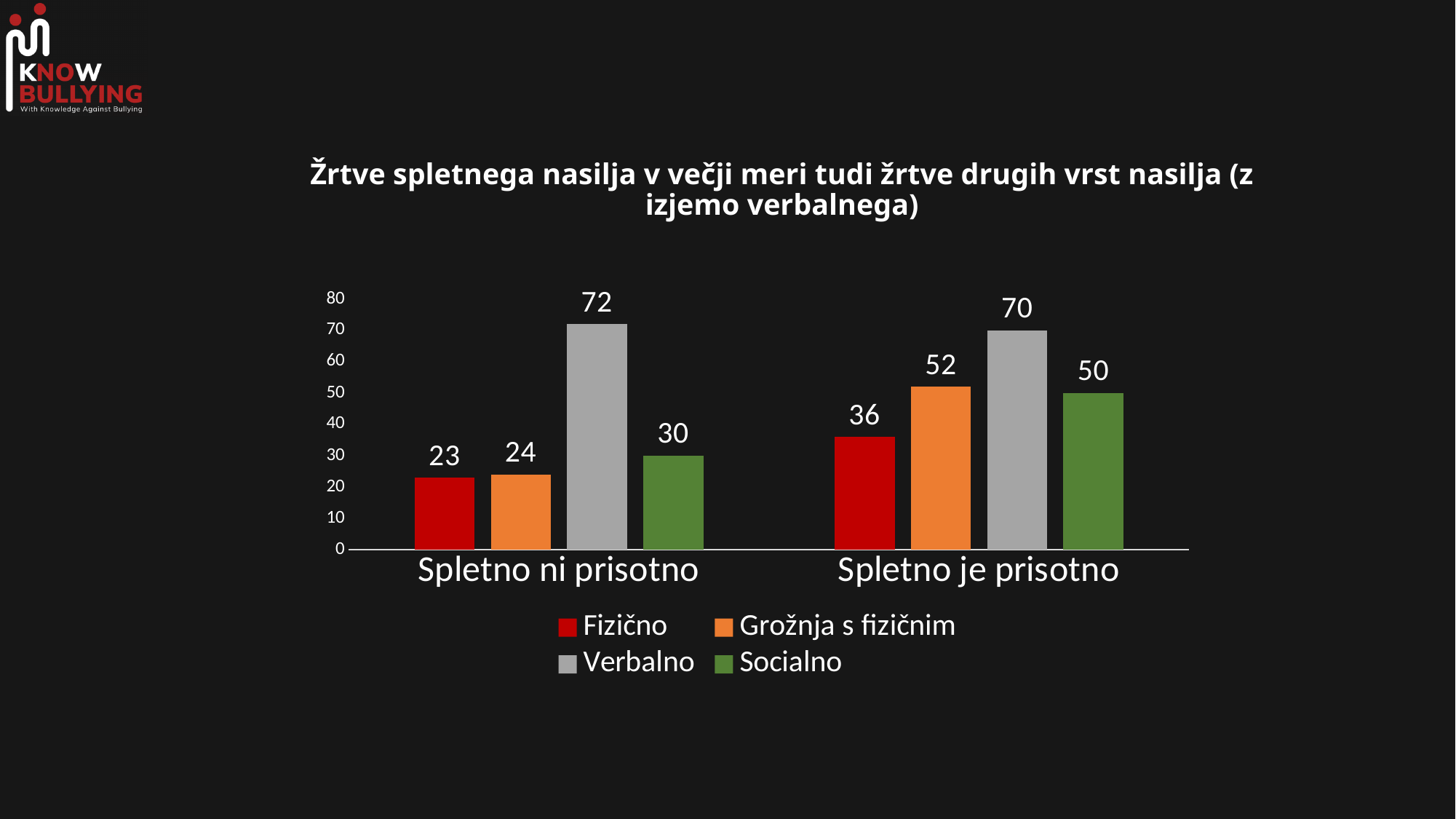
Which is larger: Socialno for Spletno ni prisotno or Socialno for Spletno je prisotno? Spletno je prisotno What kind of chart is shown on the slide? Bar chart How many series does the legend list? 4 Which colour represents the Verbalno series? Grey What is the difference between the Grožnja s fizičnim values for Spletno je prisotno and Spletno ni prisotno? 28 Which series has the highest value in the Spletno ni prisotno group? Verbalno What is the value for Socialno in the Spletno je prisotno group? 50 What is the value for Verbalno in the Spletno ni prisotno group? 72 How many categories are shown on the x axis? 2 Which series has the lowest value in the Spletno je prisotno group? Fizično What is the value for Fizično in the Spletno je prisotno group? 36 Is the value for Grožnja s fizičnim in the Spletno je prisotno group greater or less than 40? greater